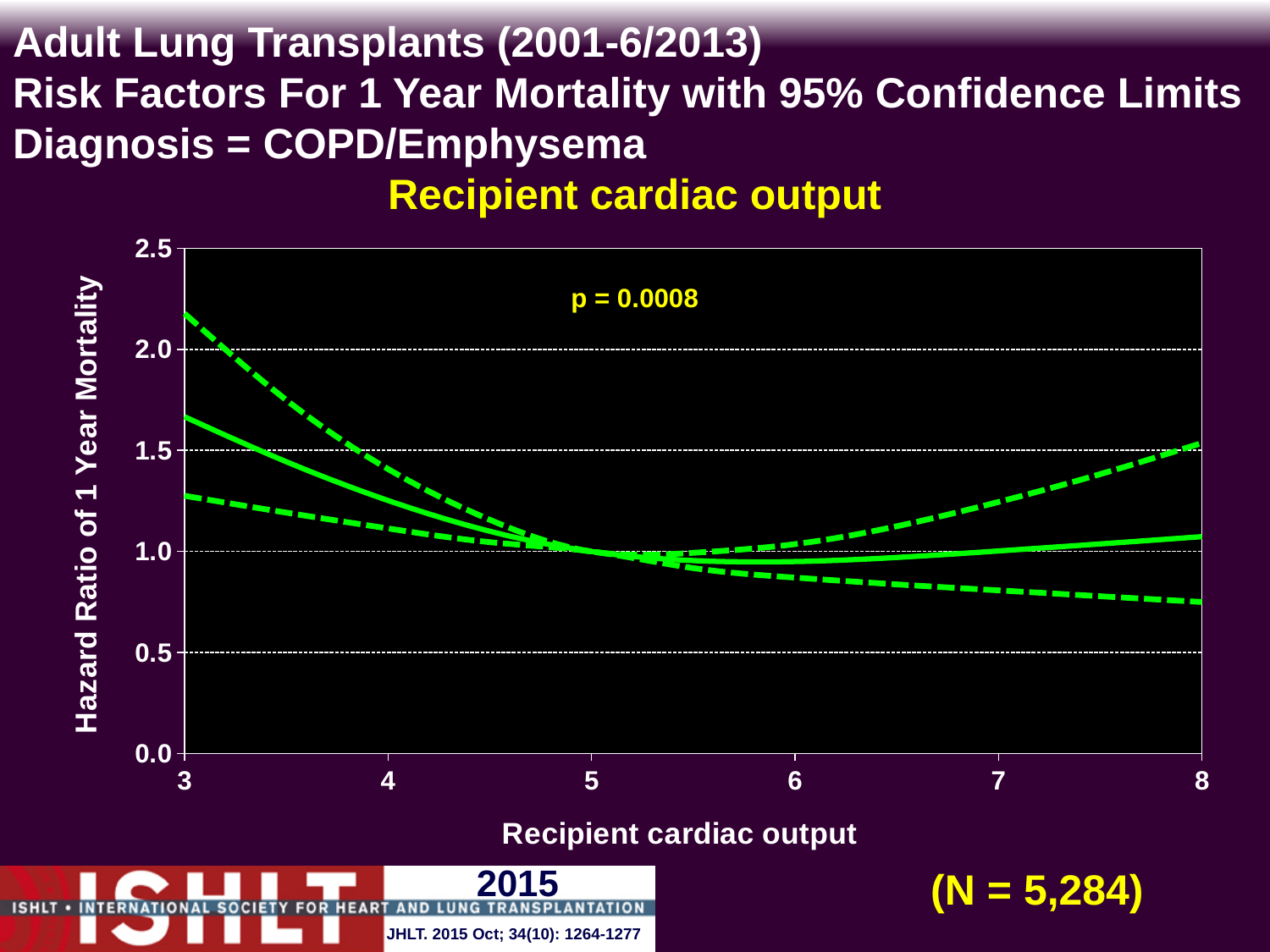
Is the upper dashed confidence limit at a recipient cardiac output of 8 greater or less than 1.0? greater What is the highest value shown on the y axis? 2.5 How many lines are plotted on the chart? 3 Does the solid hazard ratio line rise or fall as recipient cardiac output increases from 3 to 5? Fall Is the upper dashed confidence limit at a recipient cardiac output of 3 greater or less than 2.0? greater What kind of chart is shown on the slide? Line chart What p-value is printed on the chart? p = 0.0008 Is the lower dashed confidence limit at a recipient cardiac output of 8 greater or less than 1.0? less Which is larger: the solid hazard ratio line at a recipient cardiac output of 3 or at 6? At 3